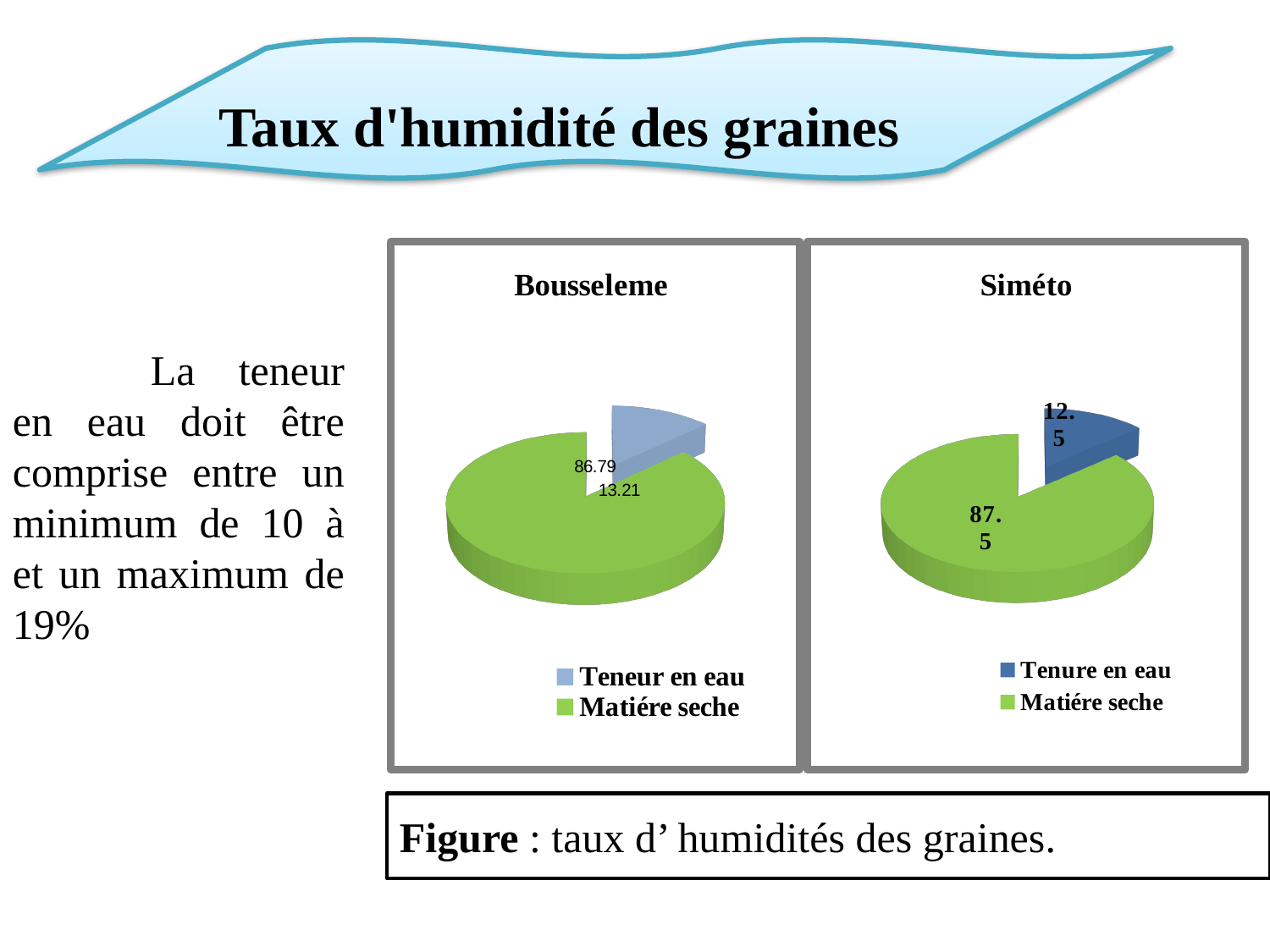
In the Bousseleme chart, which slice is the largest? Matiére seche What type of chart is the Bousseleme chart? Pie chart Which is larger: Teneur en eau in the Bousseleme chart or Tenure en eau in the Siméto chart? Teneur en eau in the Bousseleme chart In the Bousseleme chart, what is the difference between Matiére seche and Teneur en eau? 73.58 In the Siméto chart, what is the value for Matiére seche? 87.5 In the Bousseleme chart, what is the value for Matiére seche? 86.79 In the Siméto chart, what colour is the Matiére seche slice? Green In the Bousseleme chart, what is the value for Teneur en eau? 13.21 In the Siméto chart, which slice is the smallest? Tenure en eau In the Siméto chart, what is the value for Tenure en eau? 12.5 How many slices does the Siméto chart have? 2 In the Siméto chart, what is the difference between Matiére seche and Tenure en eau? 75